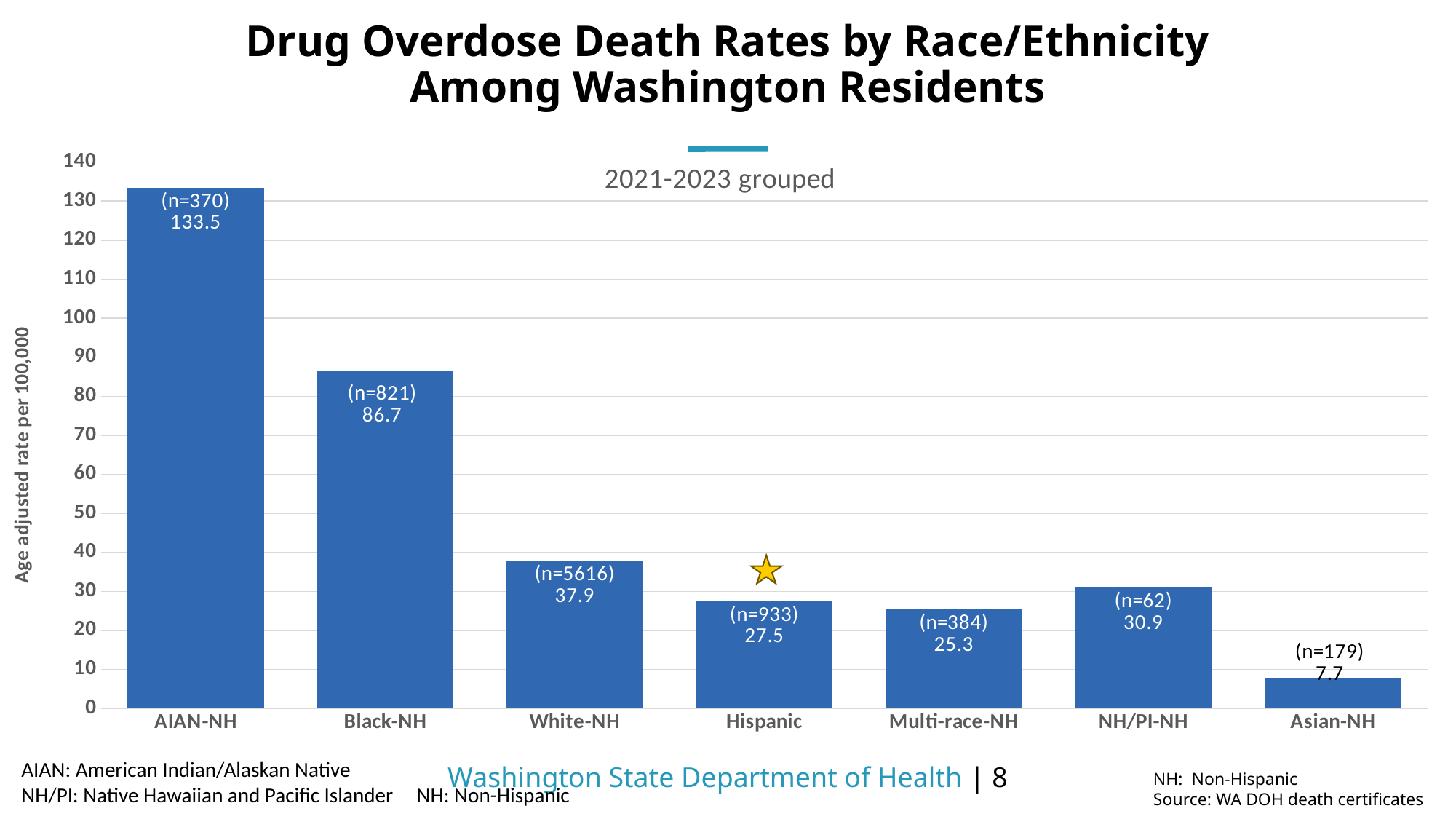
What is the age adjusted drug overdose death rate per 100,000 for AIAN-NH? 133.5 What is the number of deaths (n) shown for White-NH? 5616 What kind of chart is shown on the slide? Bar chart Is the value for Black-NH greater or less than 80? greater Which has a higher drug overdose death rate, NH/PI-NH or Multi-race-NH? NH/PI-NH Which race/ethnicity group has the lowest drug overdose death rate? Asian-NH What is the age adjusted drug overdose death rate per 100,000 for Hispanic residents? 27.5 What is the label of the vertical axis? Age adjusted rate per 100,000 What is the difference between the death rates for AIAN-NH and Black-NH? 46.8 Which race/ethnicity group has the highest drug overdose death rate? AIAN-NH How many race/ethnicity categories are shown on the chart? 7 What time period does the chart cover, according to the subtitle? 2021-2023 grouped